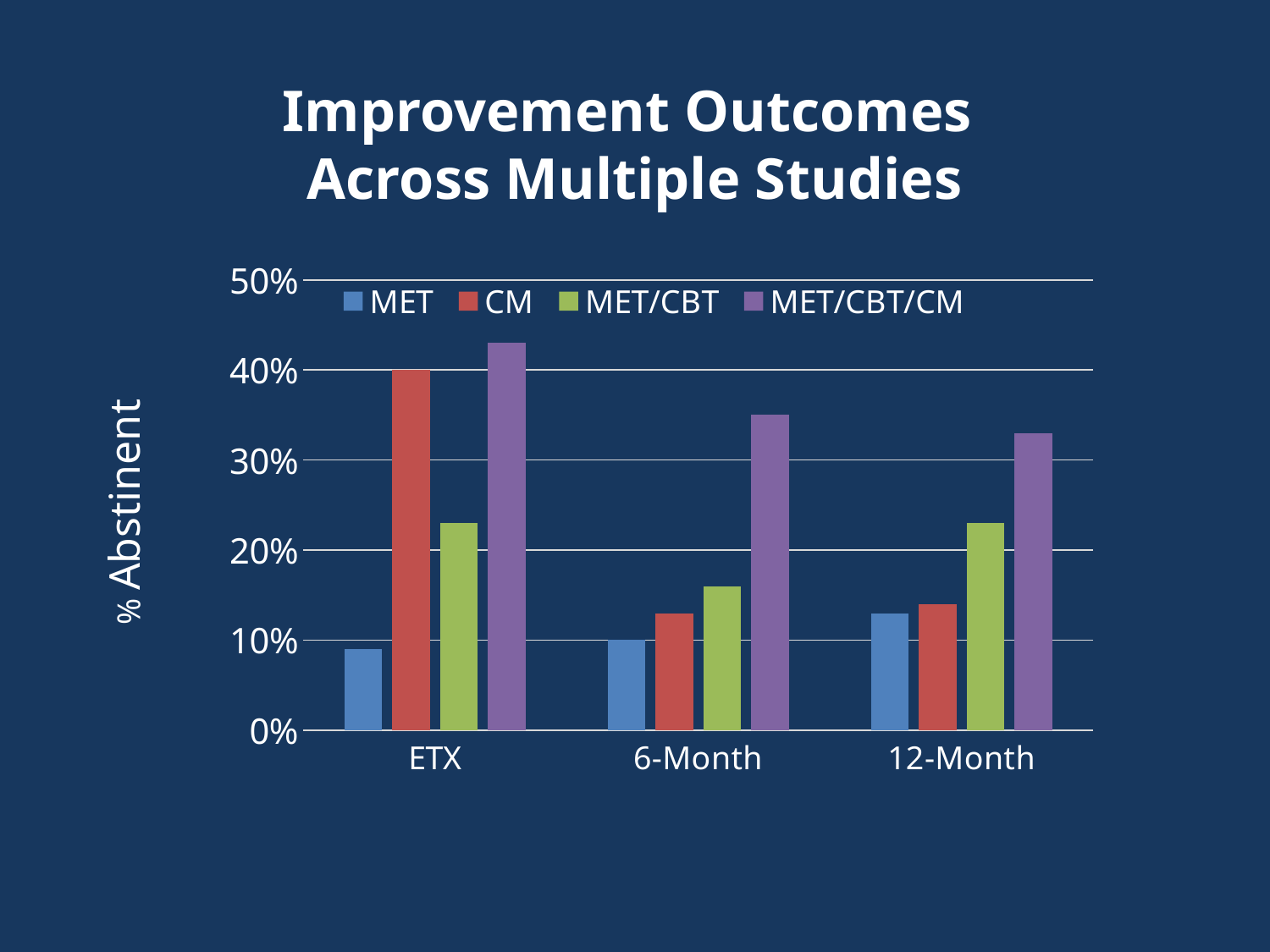
How many categories are shown on the x axis? 3 Is the value for MET/CBT at 6-Month greater or less than 20%? less How many series does the legend list? 4 What kind of chart is shown on the slide? bar chart Which is larger at ETX, CM or MET/CBT? CM What is the label on the vertical axis? % Abstinent Is the value for MET/CBT/CM at ETX greater or less than 40%? greater Do the values for MET/CBT/CM rise or fall from ETX to 12-Month? fall What is the value for MET at 6-Month? 10% Which series has the highest value at ETX? MET/CBT/CM What is the value for CM at ETX? 40% Which series has the lowest value at ETX? MET